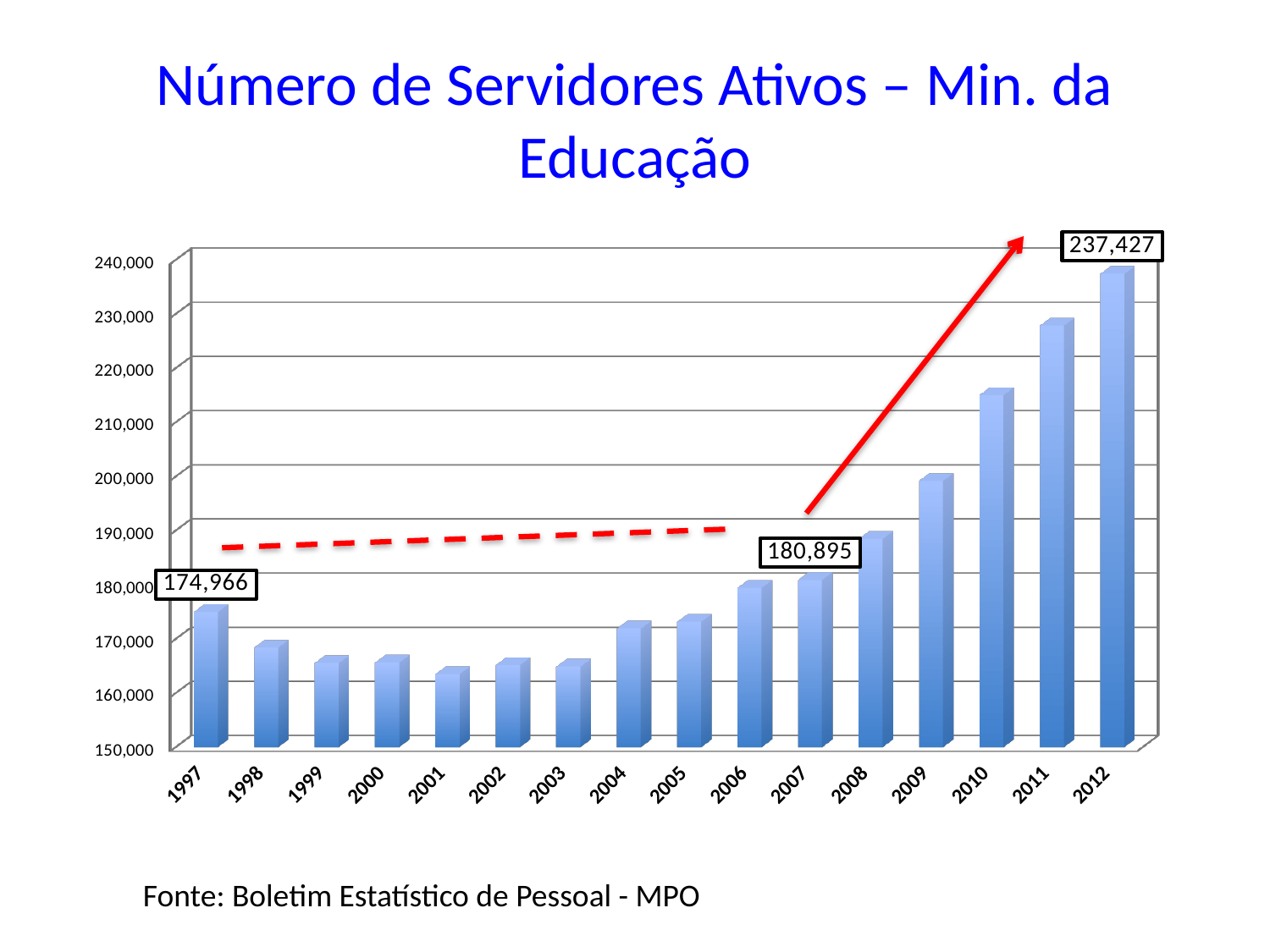
What is the difference between the values for 2012 and 2007? 56,532 Is the value for 2010 greater or less than 210,000? greater What kind of chart is shown on the slide? bar chart Which year has the highest number of active servants? 2012 Which is larger, the value for 2007 or the value for 1997? 2007 How many years are shown on the x axis? 16 What is the difference between the values for 2012 and 1997? 62,461 Is the value for 2001 greater or less than 170,000? less What is the value shown for 2012? 237,427 Do the values rise or fall from 2007 to 2012? rise What is the value shown for 2007? 180,895 What is the value shown for 1997? 174,966